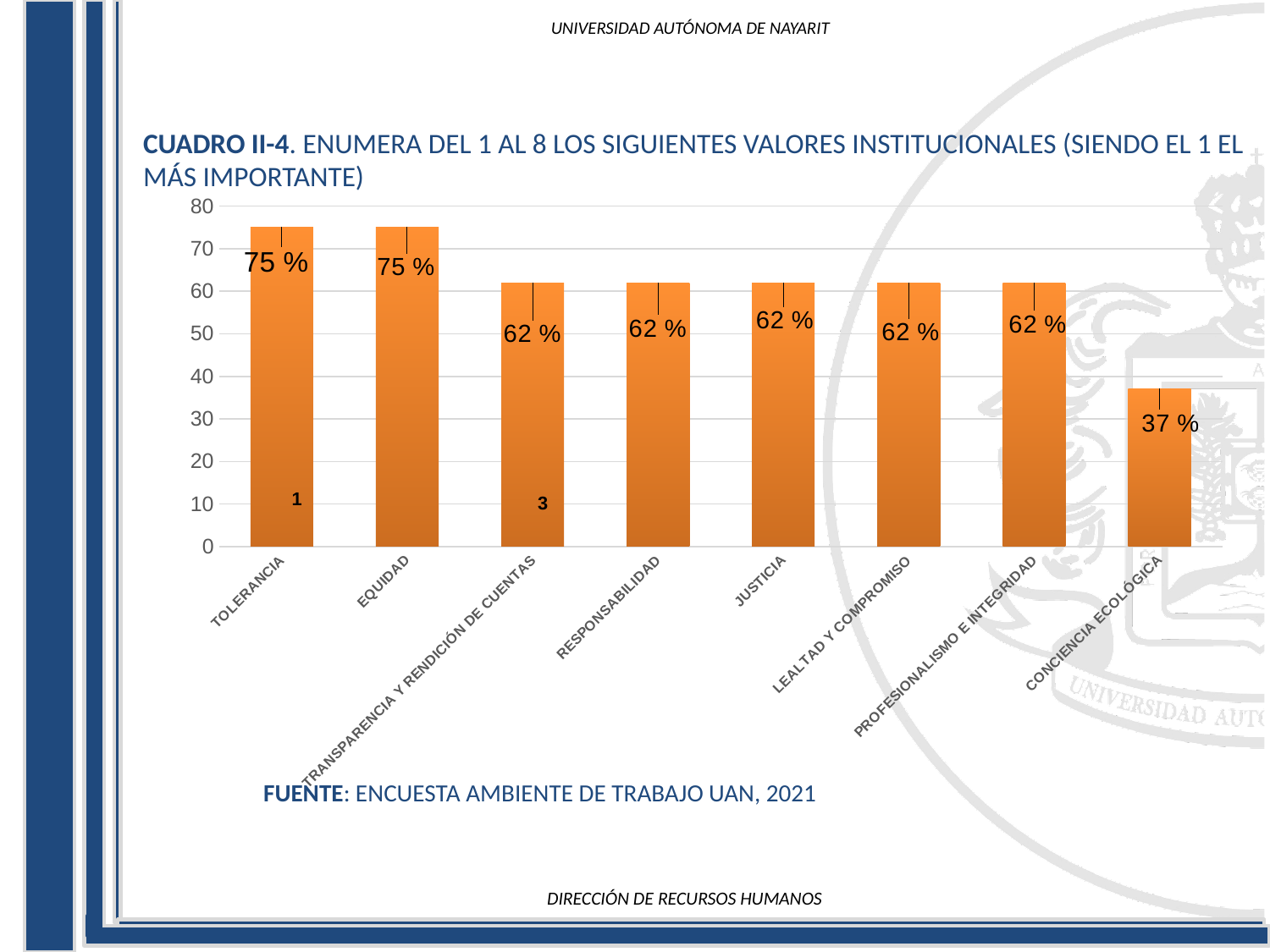
Which category has the lowest value? CONCIENCIA ECOLÓGICA What is the value for EQUIDAD? 75 % What is the value for TOLERANCIA? 75 % What kind of chart is shown on the slide? bar chart What is the value for JUSTICIA? 62 % How many categories are shown on the x axis? 8 Is the value for CONCIENCIA ECOLÓGICA greater or less than 40? less What is the difference between the value for EQUIDAD and the value for LEALTAD Y COMPROMISO? 13 % What is the value for CONCIENCIA ECOLÓGICA? 37 % What source is cited below the chart? ENCUESTA AMBIENTE DE TRABAJO UAN, 2021 Do the values rise or fall from left to right along the x axis? fall Which is larger, the value for TOLERANCIA or the value for RESPONSABILIDAD? TOLERANCIA